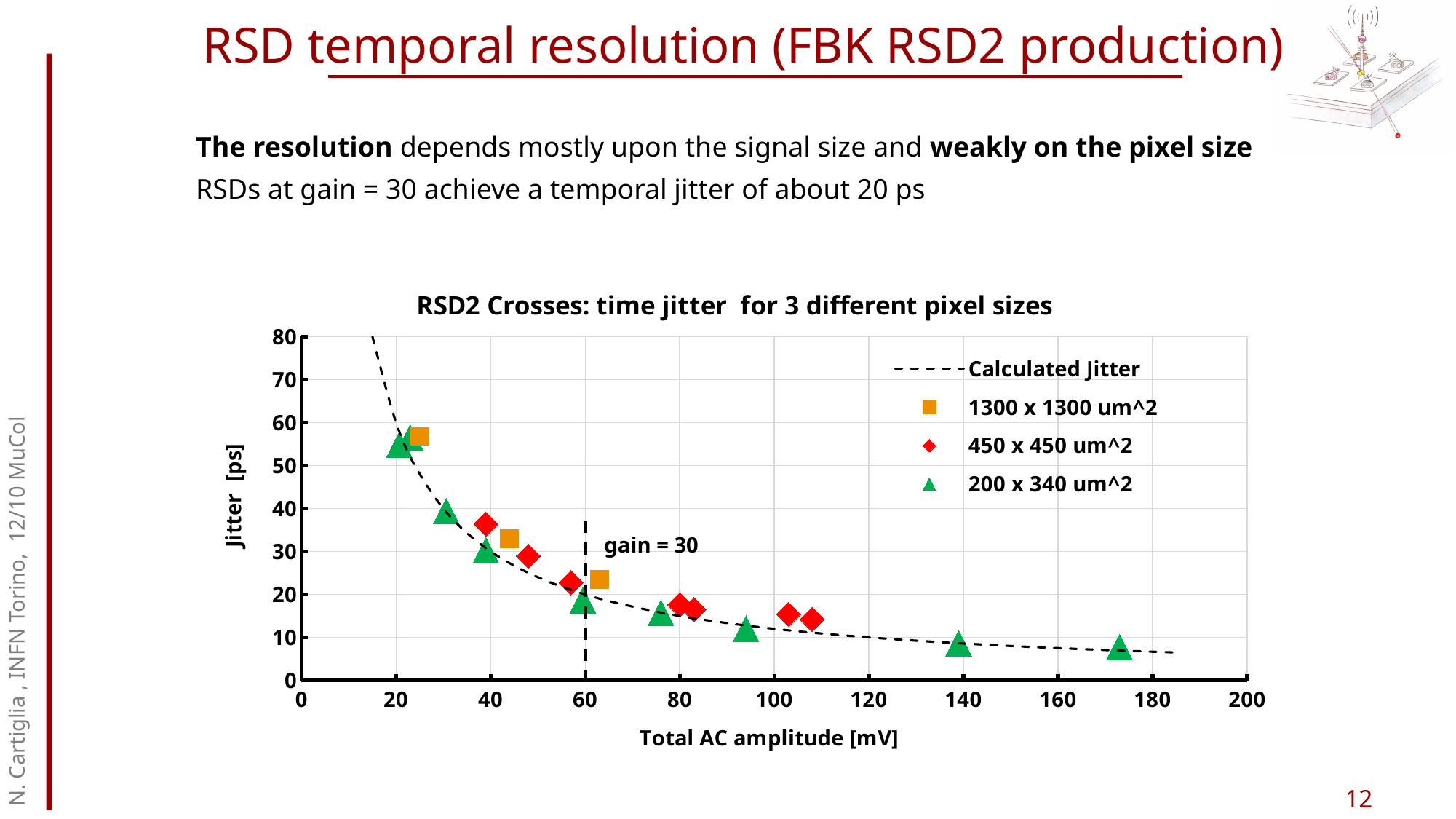
Which pixel size series has the data point with the largest total AC amplitude? 200 x 340 um^2 How many entries does the chart legend list? 4 What kind of chart is shown on the slide? scatter chart Is the jitter of the 1300 x 1300 um^2 point near 25 mV greater or less than 50 ps? greater As the total AC amplitude increases along the x axis, does the jitter rise or fall? fall What is the label of the x axis? Total AC amplitude [mV] How many orange square (1300 x 1300 um^2) data points are plotted? 3 What is the title of the chart? RSD2 Crosses: time jitter for 3 different pixel sizes Which series is drawn as a dashed line in the chart? Calculated Jitter Is the jitter of the 200 x 340 um^2 point near 173 mV greater or less than 10 ps? less Is the jitter of the 450 x 450 um^2 point near 108 mV greater or less than 20 ps? less At what total AC amplitude is the vertical dashed line labelled 'gain = 30' drawn? 60